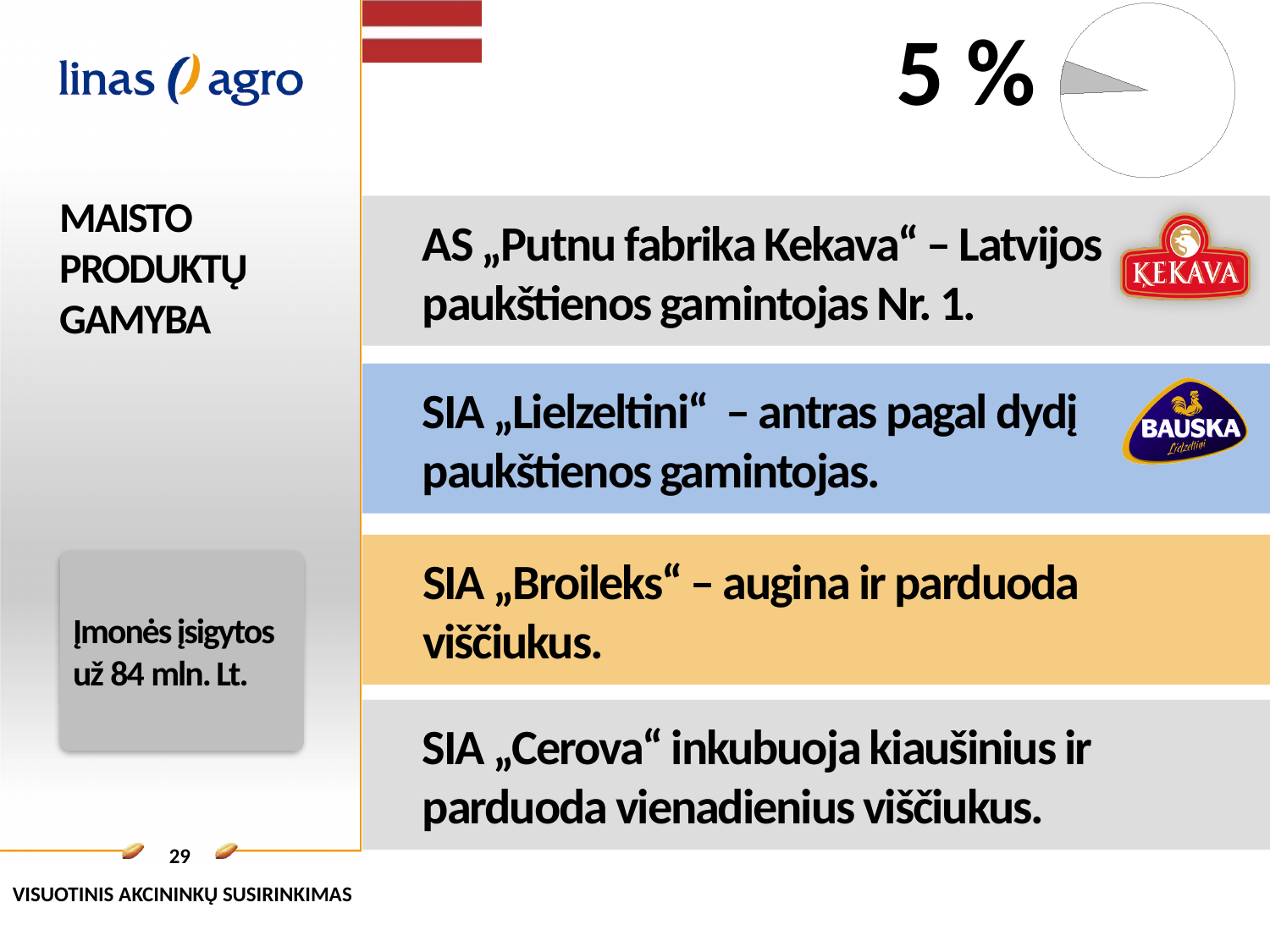
Which slice of the pie chart is the smallest? the grey slice Which slice of the pie chart is larger, the grey slice or the white slice? the white slice How many slices does the pie chart have? 2 What colour is the highlighted slice of the pie chart? grey What kind of chart is shown in the top right corner of the slide? pie chart What share of the pie does the grey (highlighted) slice represent? 5 %